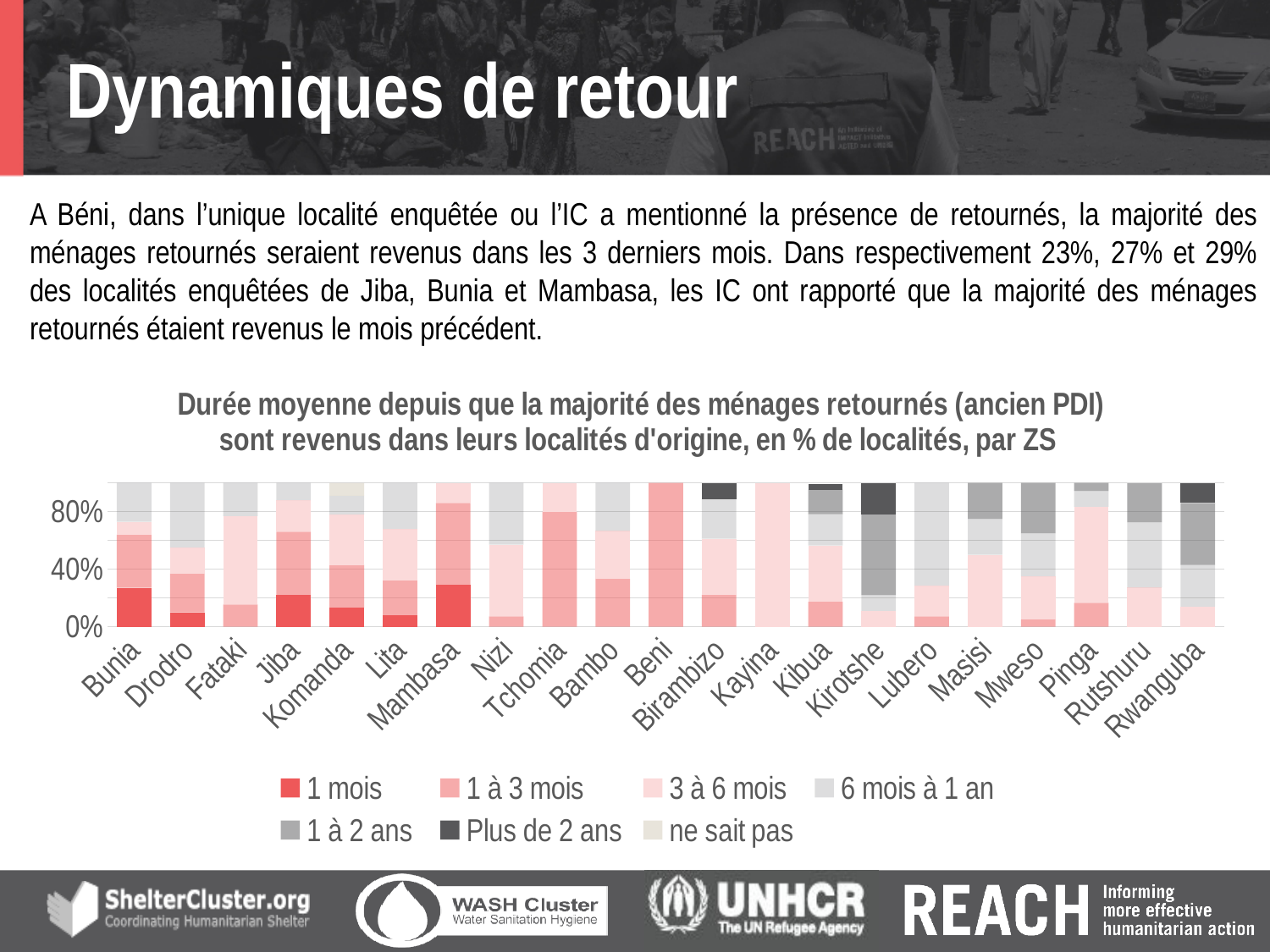
What kind of chart is shown on the slide? Stacked bar chart How many zones de santé (categories) are shown on the x axis of the chart? 21 Which zone de santé has the largest '1 à 3 mois' share? Beni Which zone de santé has the largest 'Plus de 2 ans' share? Kirotshe Is the '1 à 3 mois' value for Tchomia greater or less than 40%? greater Is the '3 à 6 mois' value for Kayina greater or less than 80%? greater Is the '1 à 3 mois' value for Beni greater or less than 80%? greater How many series does the chart legend list? 7 Is the '1 mois' share larger for Jiba or for Drodro? Jiba Which series is listed last in the chart legend? ne sait pas Which series is listed first in the chart legend? 1 mois